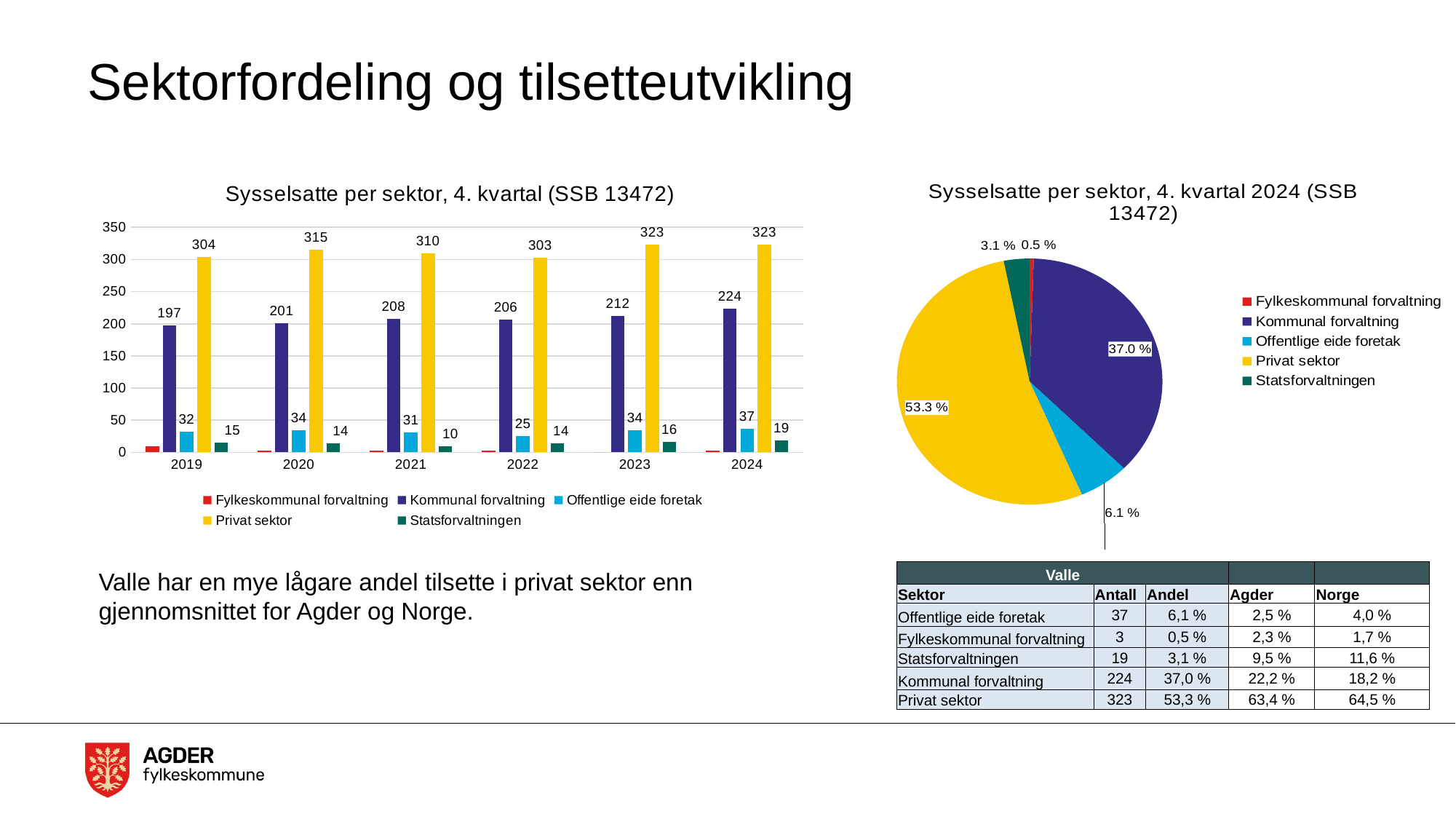
In the bar chart 'Sysselsatte per sektor, 4. kvartal (SSB 13472)', is Kommunal forvaltning higher in 2023 or in 2022? 2023 In the bar chart 'Sysselsatte per sektor, 4. kvartal (SSB 13472)', what is the value for Statsforvaltningen in 2021? 10 In the bar chart 'Sysselsatte per sektor, 4. kvartal (SSB 13472)', what is the value for Privat sektor in 2020? 315 What kind of chart is the chart on the left of the slide? bar chart In the pie chart 'Sysselsatte per sektor, 4. kvartal 2024 (SSB 13472)', which sector has the smallest slice? Fylkeskommunal forvaltning In the bar chart 'Sysselsatte per sektor, 4. kvartal (SSB 13472)', how many series does the legend list? 5 In the bar chart 'Sysselsatte per sektor, 4. kvartal (SSB 13472)', what is the value for Kommunal forvaltning in 2024? 224 In the bar chart 'Sysselsatte per sektor, 4. kvartal (SSB 13472)', how many years are shown on the x axis? 6 In the bar chart 'Sysselsatte per sektor, 4. kvartal (SSB 13472)', what is the difference between Privat sektor and Kommunal forvaltning in 2019? 107 In the bar chart 'Sysselsatte per sektor, 4. kvartal (SSB 13472)', in which year is Offentlige eide foretak lowest? 2022 In the pie chart 'Sysselsatte per sektor, 4. kvartal 2024 (SSB 13472)', what share does Privat sektor have? 53.3 % In the bar chart 'Sysselsatte per sektor, 4. kvartal (SSB 13472)', does Kommunal forvaltning rise or fall from 2019 to 2024? rise